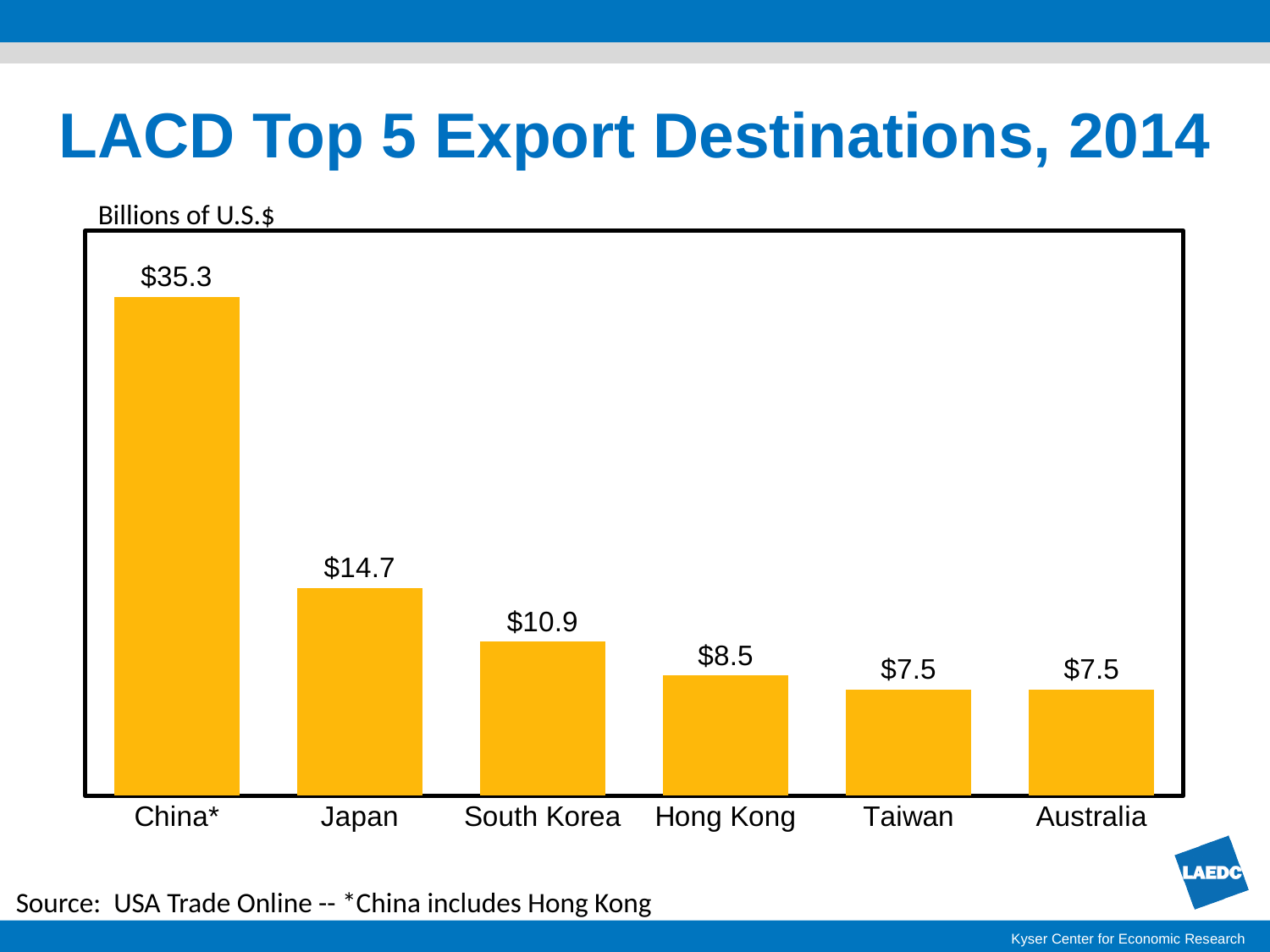
Do the values rise or fall from left to right across the chart? Fall What is the value for Japan? $14.7 What is the value for South Korea? $10.9 What is the title of the chart? LACD Top 5 Export Destinations, 2014 Which is larger, the value for Japan or the value for South Korea? Japan What unit is stated above the chart? Billions of U.S.$ Which destination has the highest value? China* What kind of chart is shown on the slide? Bar chart What is the difference between the values for South Korea and Hong Kong? $2.4 What is the difference between the values for China* and Japan? $20.6 How many destinations are shown on the chart? 6 What is the value for Hong Kong? $8.5